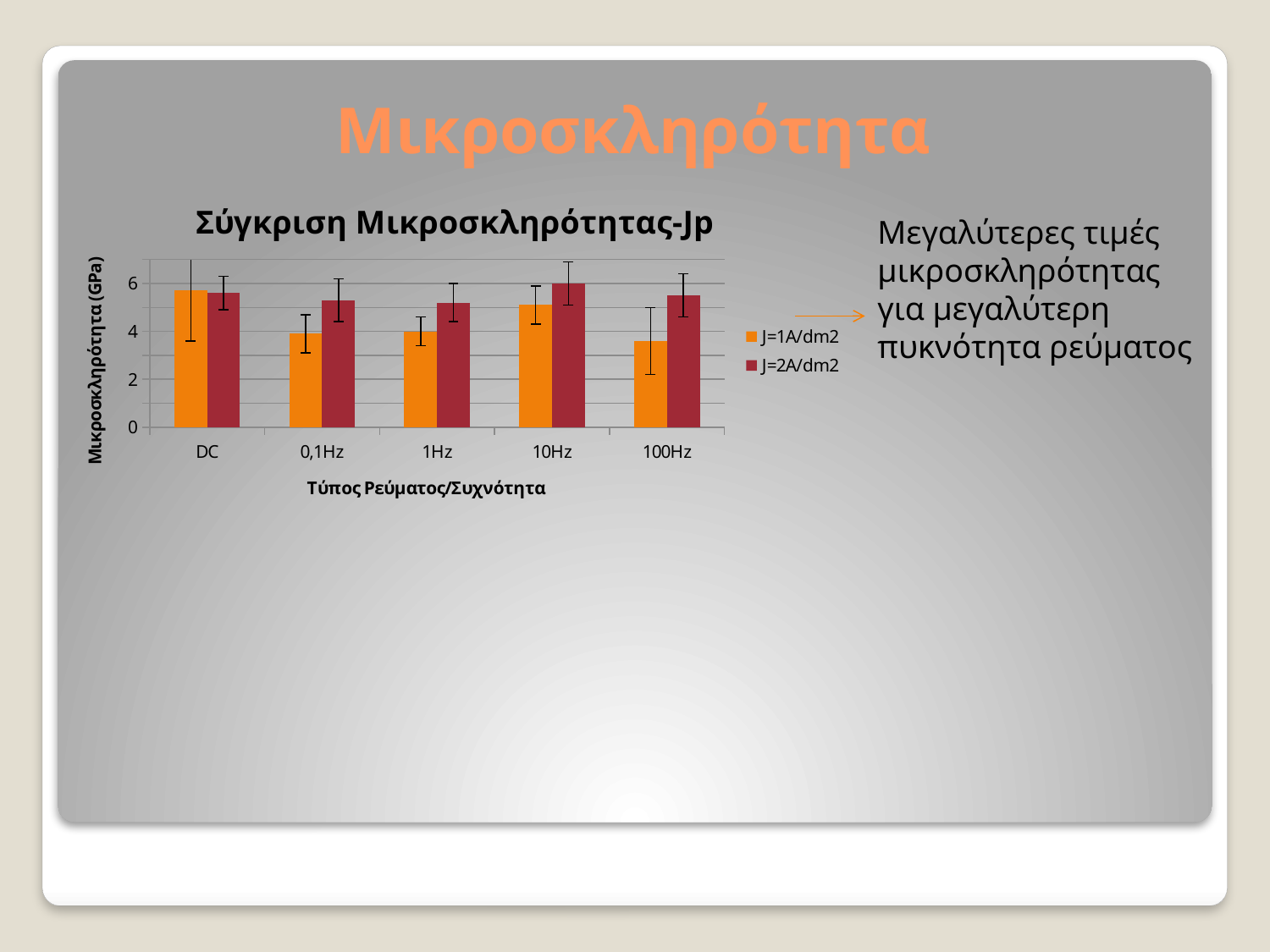
What kind of chart is shown on the slide? bar chart What is the title of the chart? Σύγκριση Μικροσκληρότητας-Jp What are the two series listed in the legend? J=1A/dm2 and J=2A/dm2 How many categories are shown on the x axis? 5 For which category is the J=2A/dm2 value highest? 10Hz Is the value for J=1A/dm2 at 100Hz greater or less than 4? less Is the value for J=2A/dm2 at 0,1Hz greater or less than 4? greater For which category is the J=1A/dm2 value highest? DC At 100Hz, which series has the larger value, J=1A/dm2 or J=2A/dm2? J=2A/dm2 Is the value for J=1A/dm2 at DC greater or less than 4? greater How many series does the legend list? 2